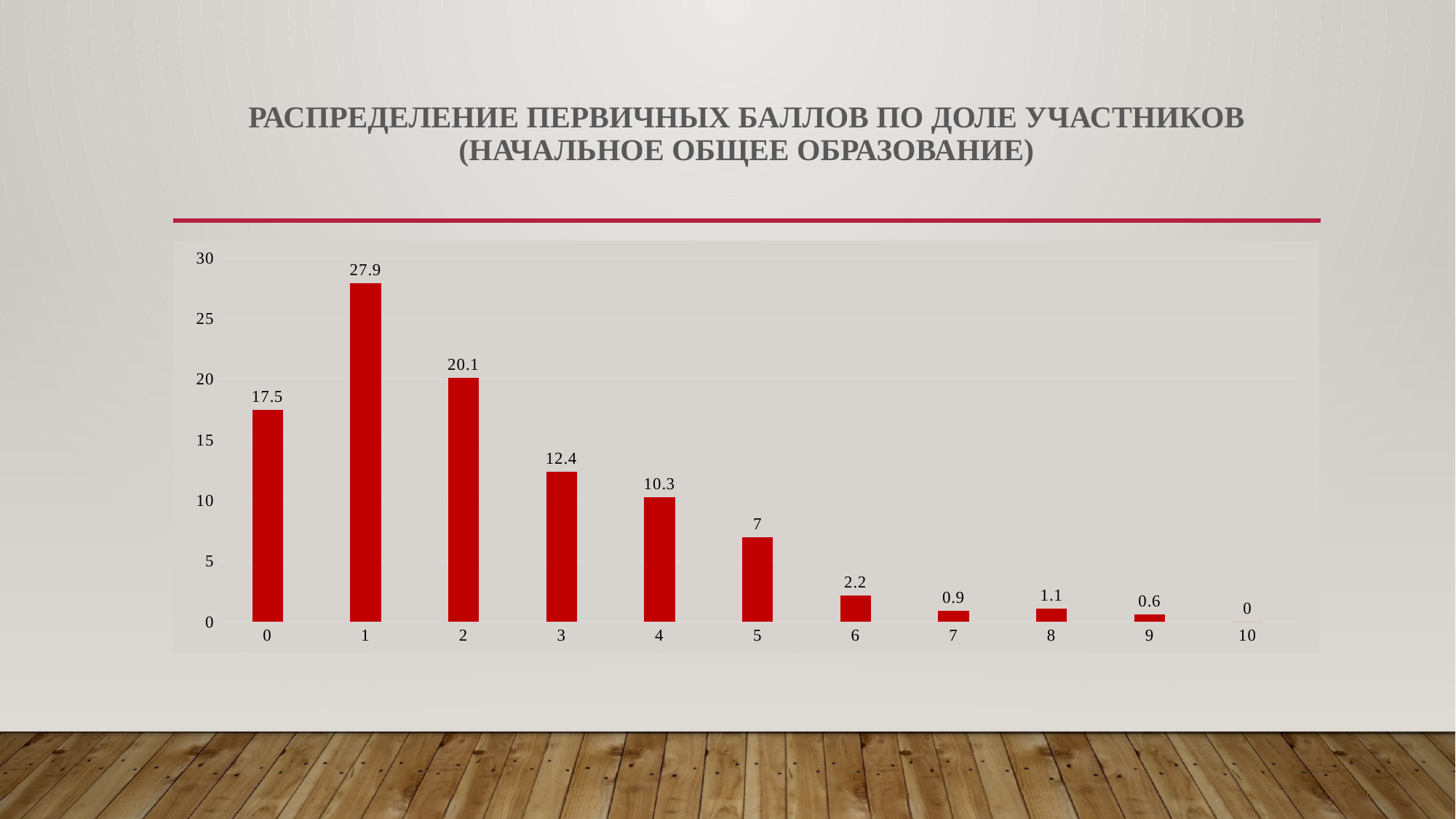
Which score has the lowest value? 10 Do the values generally rise or fall from score 1 to score 10? fall Which score has the highest value? 1 What is the value for score 4? 10.3 What is the difference between the values for score 0 and score 3? 5.1 Which is larger, the value for score 7 or the value for score 8? 8 What is the value for score 8? 1.1 What kind of chart is shown on the slide? bar chart Is the value for score 2 greater or less than 20? greater What is the value for score 1? 27.9 How many score categories are shown on the x axis? 11 What is the difference between the values for score 1 and score 2? 7.8